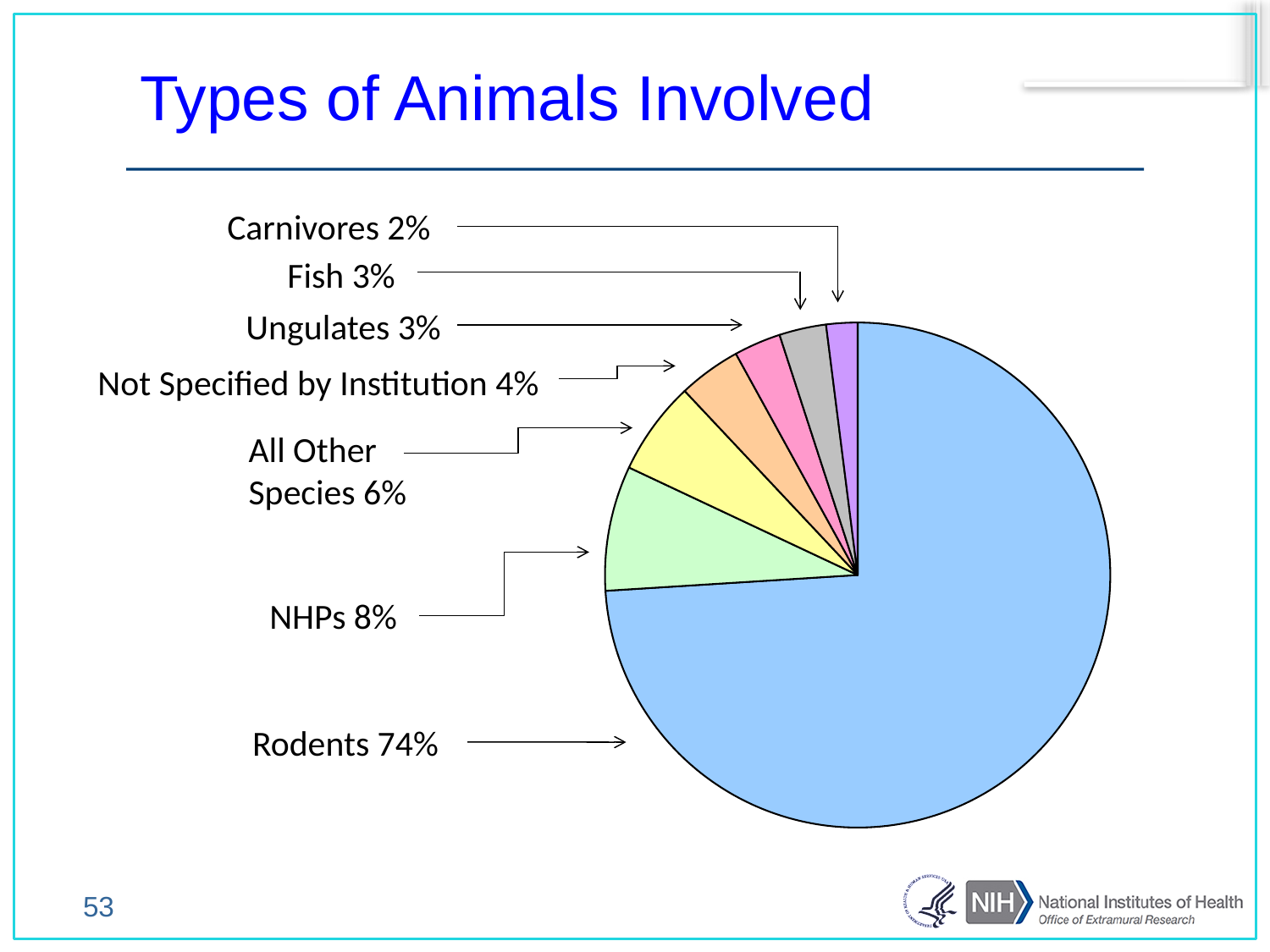
Which category has the smallest slice of the pie? Carnivores What is the difference in percentage points between Rodents and NHPs? 66 What type of chart is shown on the slide? Pie chart What percentage is shown for All Other Species? 6% Which is larger, the share for NHPs or the share for All Other Species? NHPs What percentage is shown for Not Specified by Institution? 4% Which category has the largest slice of the pie? Rodents How many categories are shown in the pie chart? 7 What percentage is shown for Carnivores? 2% What percentage is shown for NHPs? 8% What is the title of the slide containing the chart? Types of Animals Involved What share of the pie do Rodents account for? 74%